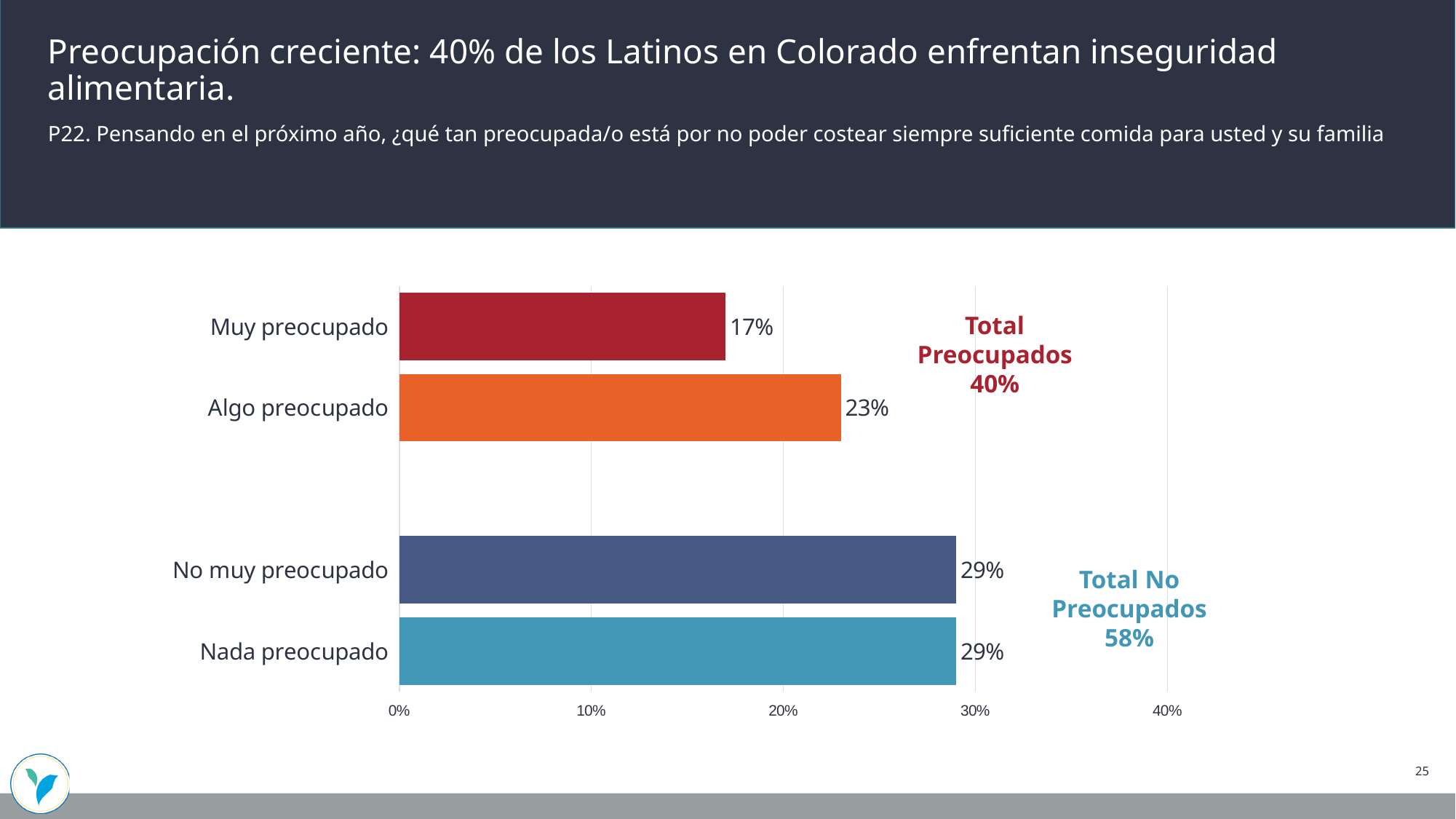
What is the Total No Preocupados percentage shown on the chart? 58% What is the value for Nada preocupado? 29% Is the value for Algo preocupado greater or less than 20%? greater How many categories are shown in the chart? 4 What is the value for No muy preocupado? 29% What is the value for Algo preocupado? 23% What is the value for Muy preocupado? 17% What is the Total Preocupados percentage shown on the chart? 40% What kind of chart is shown on the slide? Bar chart What is the difference between the values for Algo preocupado and Muy preocupado? 6 percentage points Which category has the lowest value? Muy preocupado Which is larger, the value for No muy preocupado or the value for Algo preocupado? No muy preocupado